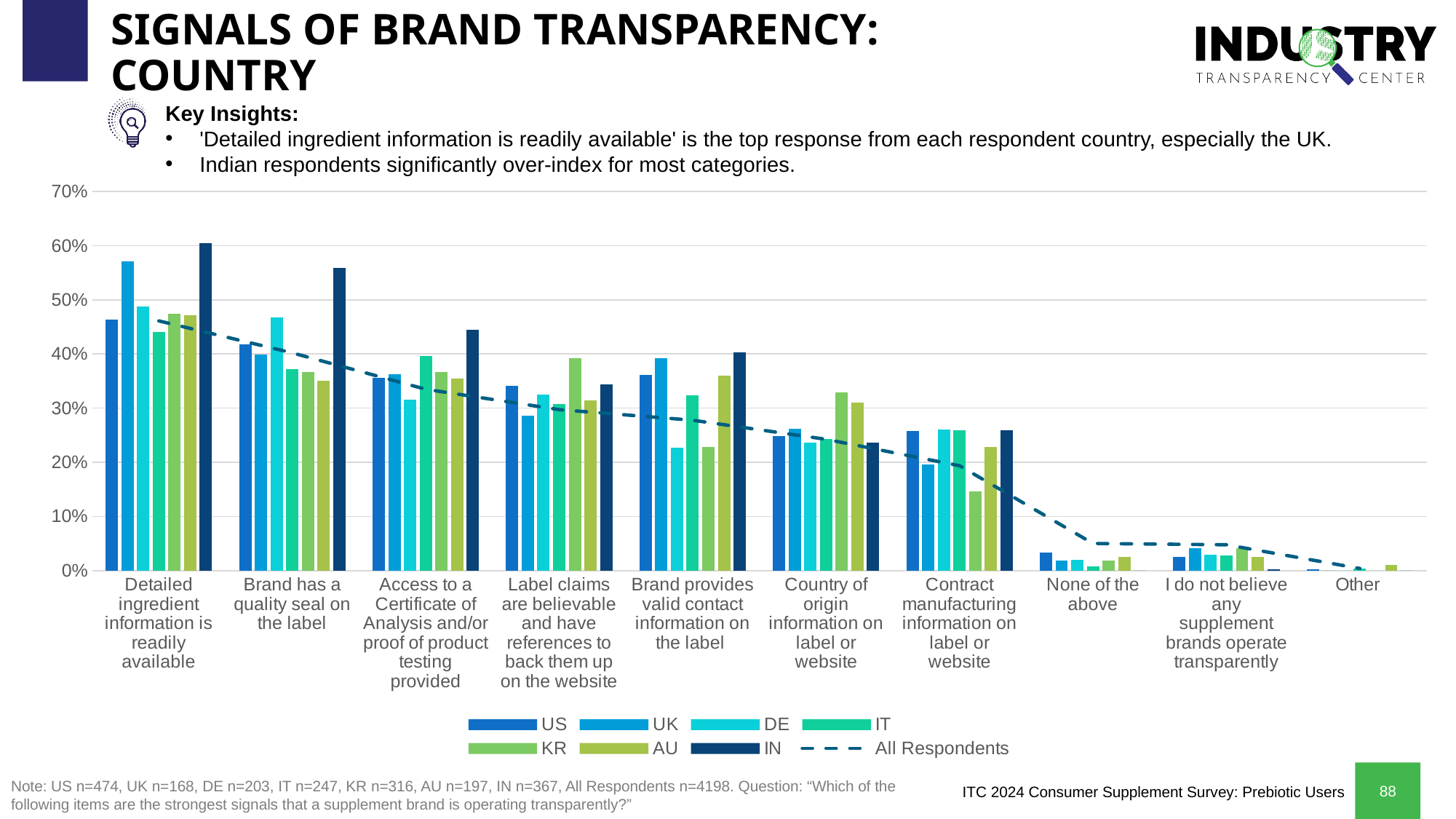
How many response categories are shown along the x axis? 10 For 'Country of origin information on label or website', which is larger: the KR value or the US value? KR Which country has the highest value for 'Brand has a quality seal on the label'? IN Does the dashed 'All Respondents' line rise or fall from left to right across the categories? Fall Is the KR value for 'Contract manufacturing information on label or website' greater or less than 20%? less What kind of chart is shown on the slide? Combination bar and line chart Which country has the highest value for 'Label claims are believable and have references to back them up on the website'? KR Is the DE value for 'Brand provides valid contact information on the label' greater or less than 30%? less Which country has the lowest value for 'Contract manufacturing information on label or website'? KR How many series does the legend list? 8 Is the UK value for 'Detailed ingredient information is readily available' greater or less than 50%? greater Which country has the highest value for 'Detailed ingredient information is readily available'? IN